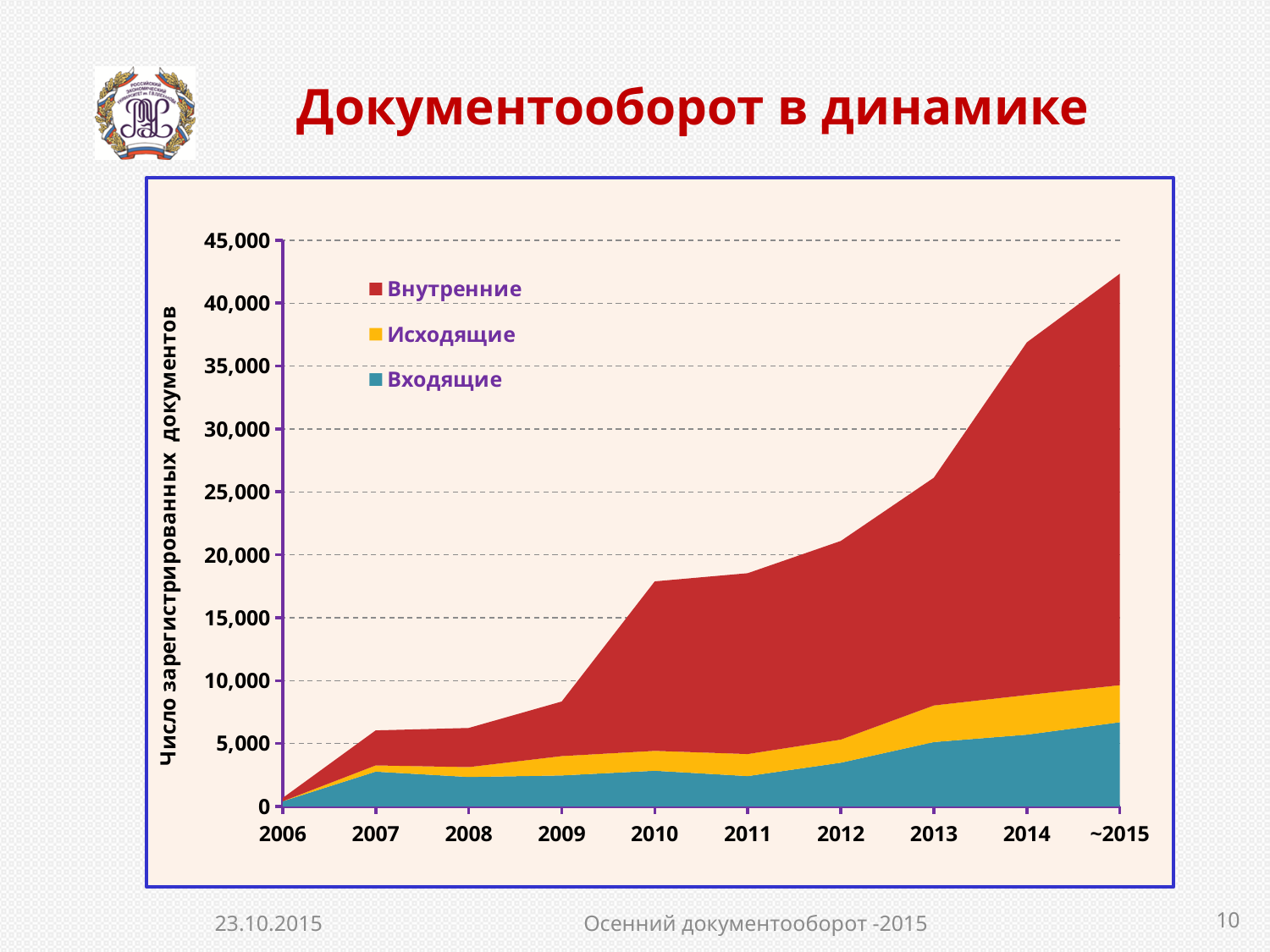
Is the total number of documents in 2013 greater or less than 30,000? less What is the label of the vertical axis? Число зарегистрированных документов Is the total number of documents in ~2015 greater or less than 40,000? greater In which year is the total number of registered documents highest? ~2015 Does the total number of registered documents rise or fall from 2006 to ~2015? Rise How many series does the legend list? 3 Which series is shown in red in the legend? Внутренние Is the total number of documents in 2009 greater or less than 10,000? less In which year is the total number of registered documents lowest? 2006 How many years are shown along the x axis? 10 Which year has the larger total number of documents, 2010 or 2014? 2014 What kind of chart is shown on the slide? Stacked area chart